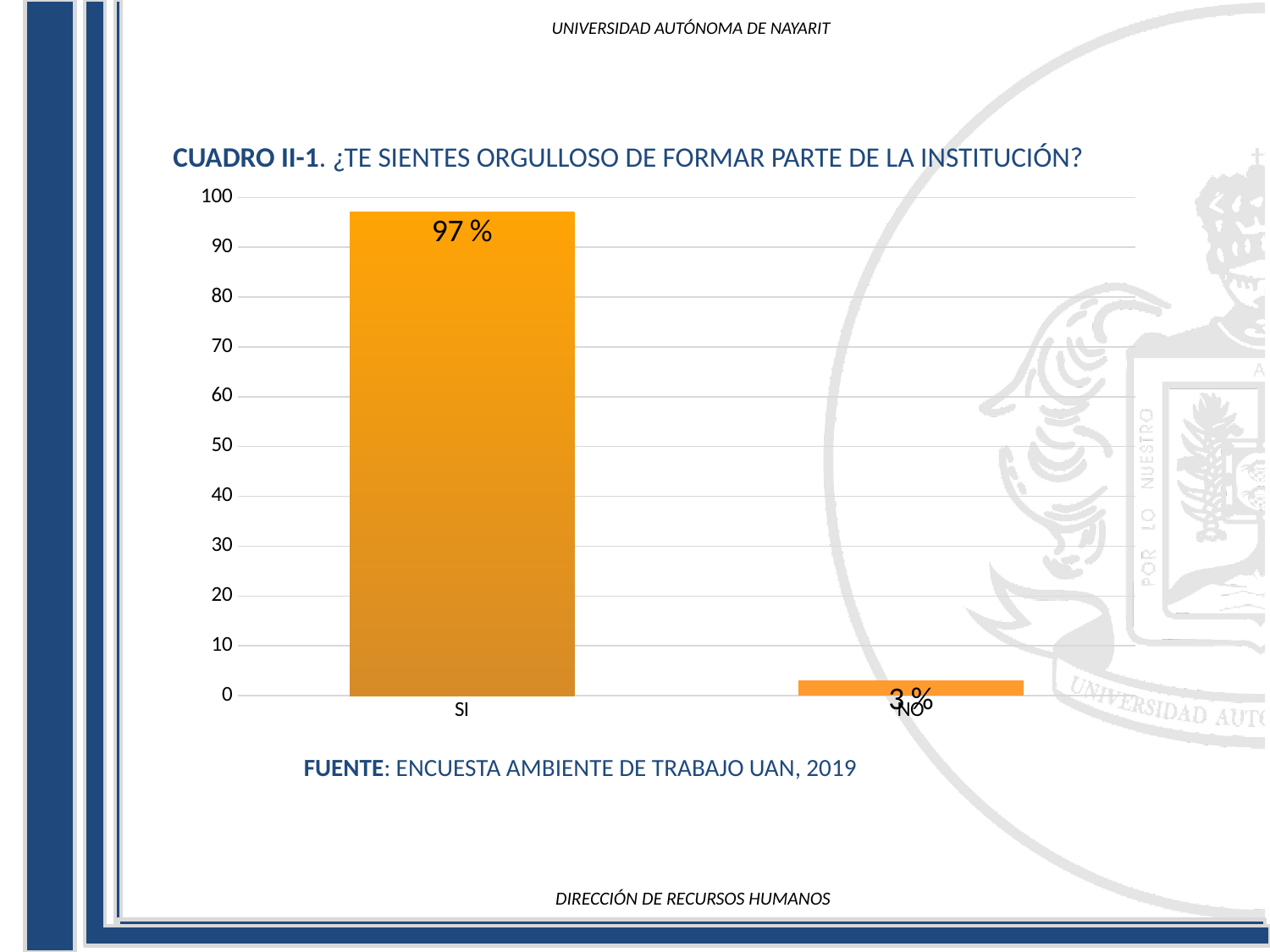
What is the difference between the values for SI and NO? 94 % Which category has the lowest value? NO What source is cited below the chart? ENCUESTA AMBIENTE DE TRABAJO UAN, 2019 What is the value for SI? 97 % Which is larger, the value for SI or the value for NO? SI What is the title of the chart? CUADRO II-1. ¿TE SIENTES ORGULLOSO DE FORMAR PARTE DE LA INSTITUCIÓN? Is the value for NO greater or less than 10? less What kind of chart is shown on the slide? bar chart How many categories are shown on the chart? 2 Which category has the highest value? SI Is the value for SI greater or less than 90? greater What is the value for NO? 3 %